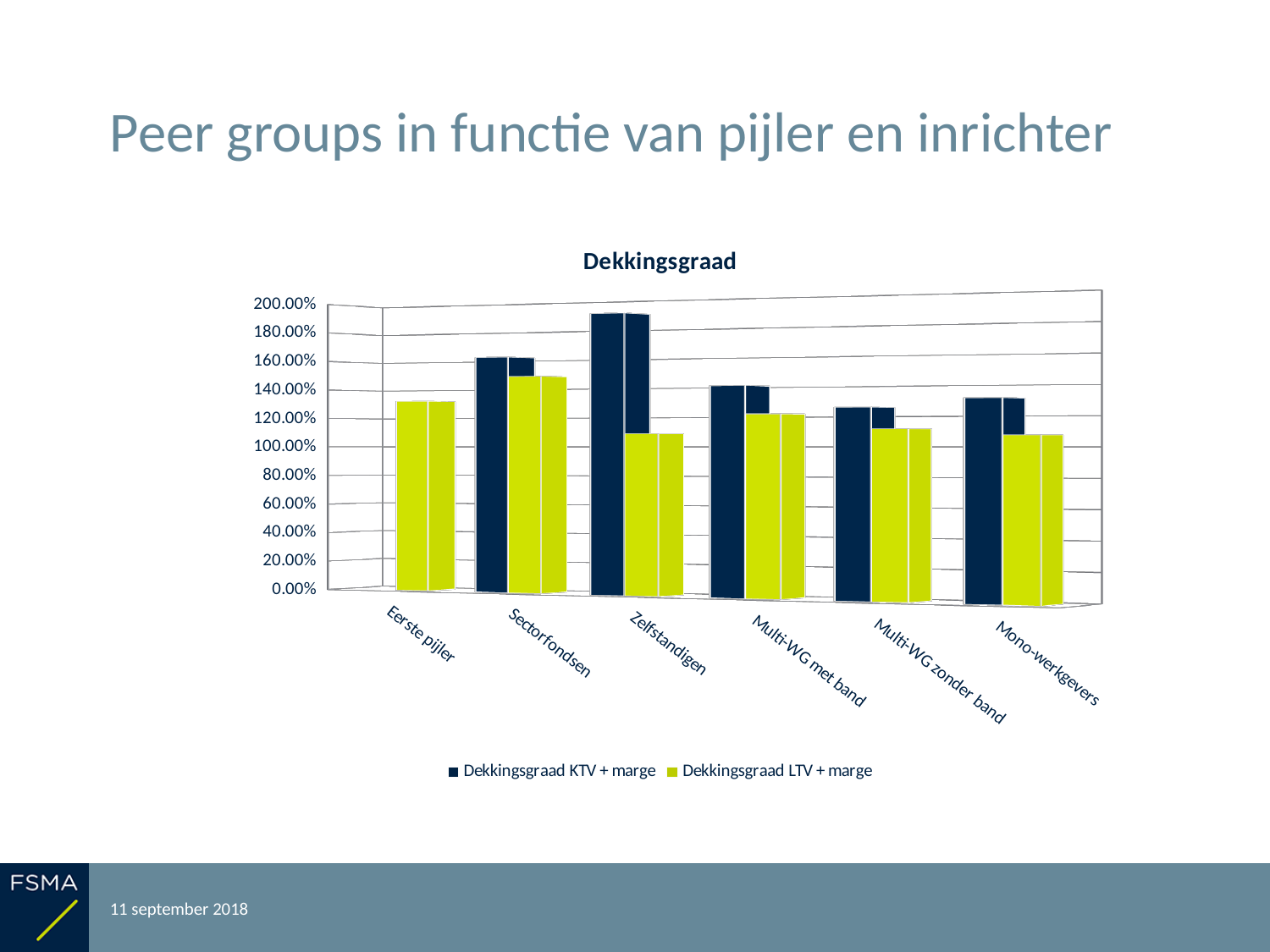
Which is larger: Dekkingsgraad KTV + marge for Sectorfondsen or for Multi-WG zonder band? Sectorfondsen Is the value for Dekkingsgraad KTV + marge for Zelfstandigen greater or less than 180.00%? greater For Zelfstandigen, which is larger: Dekkingsgraad KTV + marge or Dekkingsgraad LTV + marge? Dekkingsgraad KTV + marge Is the value for Dekkingsgraad LTV + marge for Zelfstandigen greater or less than 120.00%? less Which category has the highest value for Dekkingsgraad LTV + marge? Sectorfondsen Is the value for Dekkingsgraad LTV + marge for Sectorfondsen greater or less than 140.00%? greater What kind of chart is shown on the slide? bar chart What is the title of the chart? Dekkingsgraad Which category has the highest value for Dekkingsgraad KTV + marge? Zelfstandigen How many categories are shown on the x axis of the chart? 6 How many series does the legend list? 2 Which series is shown in dark blue in the chart? Dekkingsgraad KTV + marge